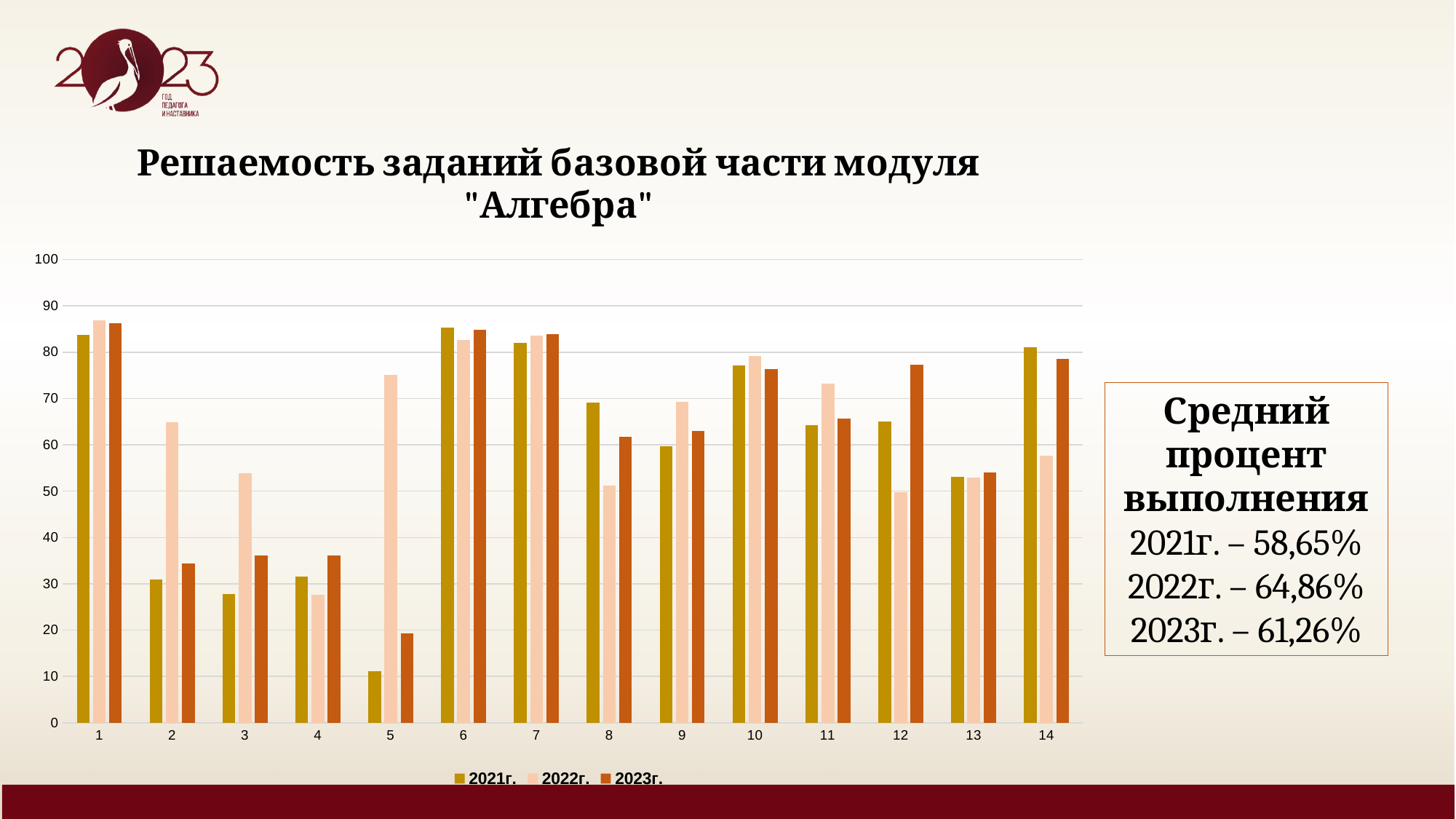
For which task is the 2022г. value the highest? 1 How many task categories are shown along the x axis of the chart? 14 Which series are listed in the chart legend? 2021г., 2022г., 2023г. How many series does the chart legend list? 3 Is the 2023г. value for task 14 greater or less than 70? greater For which task is the 2021г. value the lowest? 5 For task 2, which series has the larger value, 2021г. or 2022г.? 2022г. Is the 2021г. value for task 5 greater or less than 20? less For which task is the 2023г. value the lowest? 5 For task 12, which series has the larger value, 2022г. or 2023г.? 2023г. Is the 2022г. value for task 5 greater or less than 70? greater What kind of chart is shown on the slide? bar chart